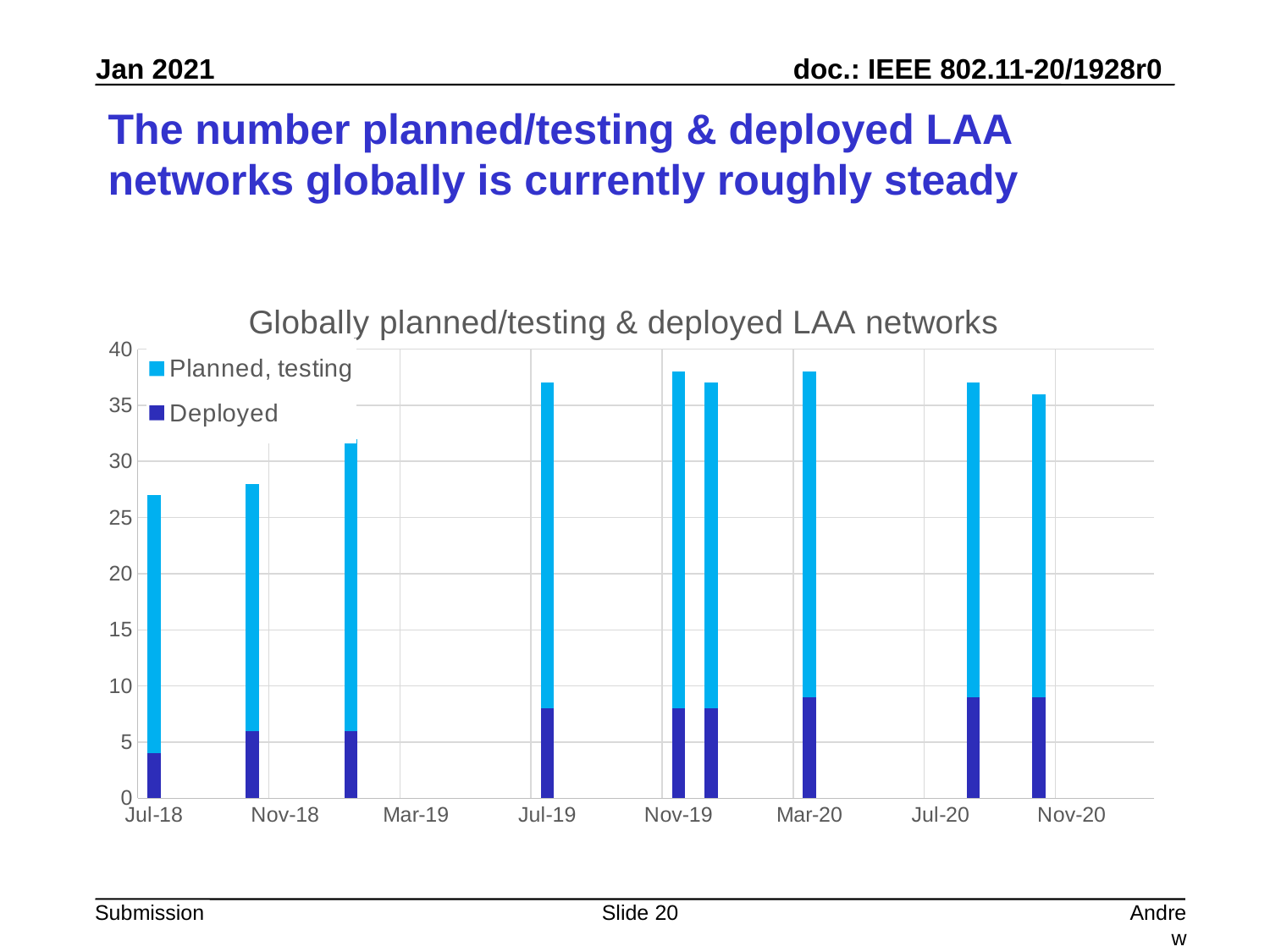
How many bars are plotted in the chart? 9 Do the bar totals rise or fall from Jul-18 to Jul-19? rise Is the Deployed value at Mar-20 greater or less than 10? less Is the Deployed value at Jul-18 greater or less than 5? less Which bar has the lowest total in the chart? Jul-18 Is the total height of the bar at Jul-19 greater or less than 35? greater What is the title of the chart? Globally planned/testing & deployed LAA networks How many series does the legend list? 2 Which bar has the lowest total, Jul-18 or Jul-19? Jul-18 What are the two series named in the legend? Planned, testing; Deployed What kind of chart is shown on the slide? Stacked bar chart